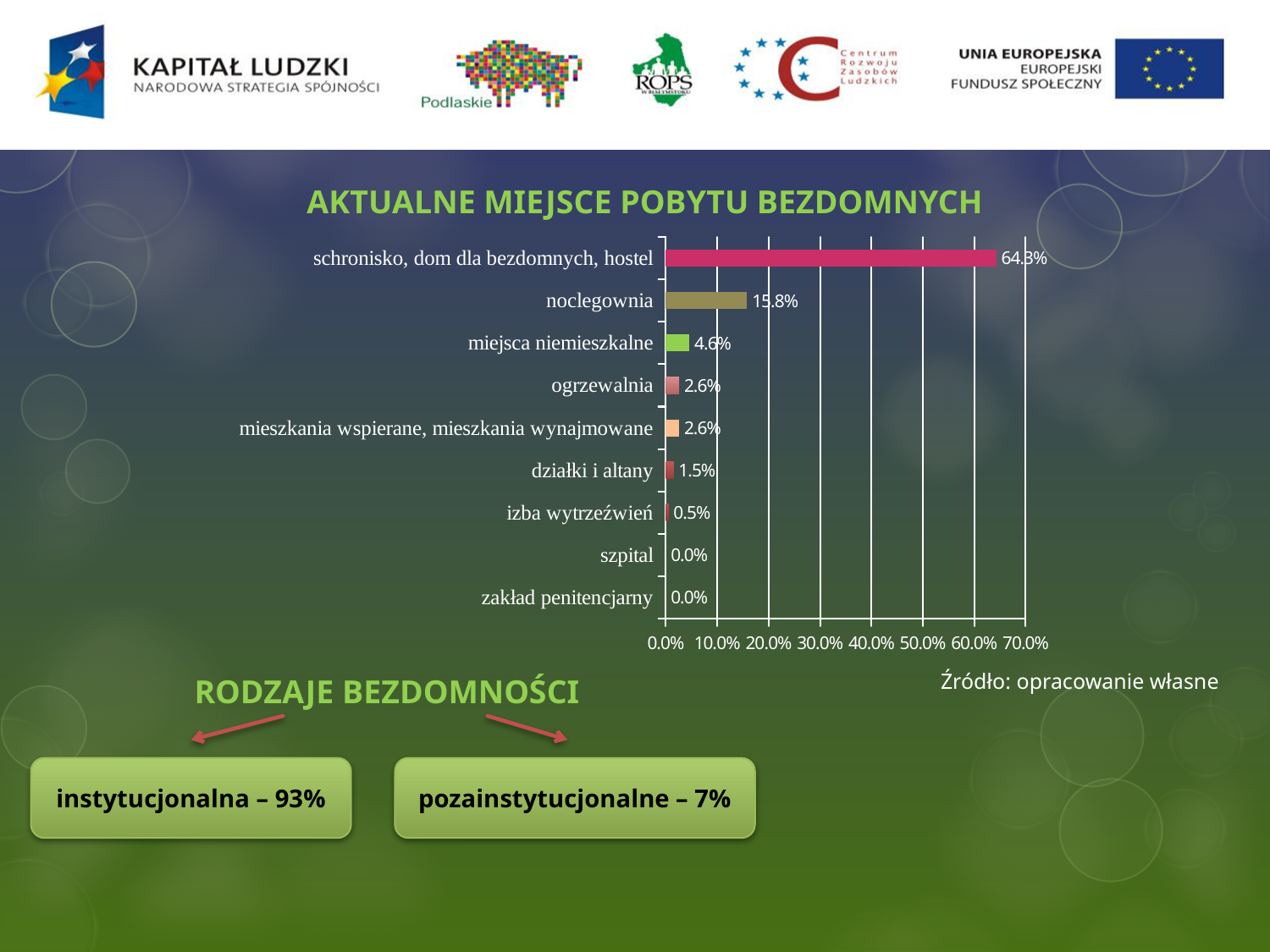
What is the value for noclegownia? 15.8% What is the value for działki i altany? 1.5% What is the title of the chart? AKTUALNE MIEJSCE POBYTU BEZDOMNYCH What is the value for schronisko, dom dla bezdomnych, hostel? 64.3% Which category has the highest value? schronisko, dom dla bezdomnych, hostel What is the difference between the values for schronisko, dom dla bezdomnych, hostel and noclegownia? 48.5% Which categories have a value of 0.0%? szpital and zakład penitencjarny Is the value for schronisko, dom dla bezdomnych, hostel greater or less than 60.0%? greater How many categories are shown in the chart? 9 What is the value for izba wytrzeźwień? 0.5% What kind of chart is shown on the slide? bar chart Which is larger, the value for miejsca niemieszkalne or the value for ogrzewalnia? miejsca niemieszkalne